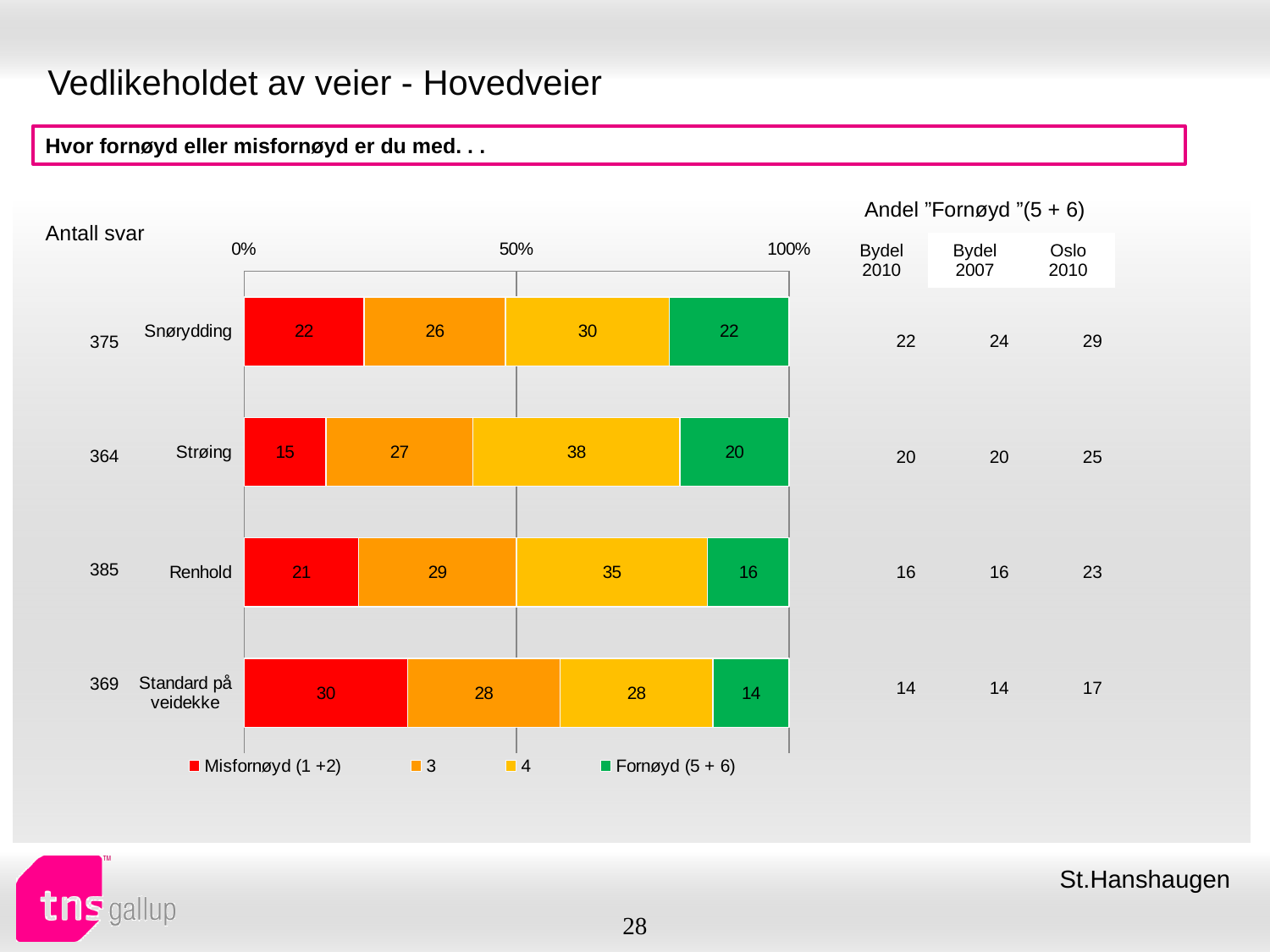
What is the total of the stacked bar for Renhold? 101 How many series does the legend list? 4 Which is larger: the 'Fornøyd (5 + 6)' value for Strøing or for Renhold? Strøing What is the value of the '4' segment for Strøing? 38 What is the value of the 'Misfornøyd (1 +2)' segment for Standard på veidekke? 30 Which category has the highest 'Misfornøyd (1 +2)' value? Standard på veidekke What is the difference between the '3' segment for Renhold and the '3' segment for Snørydding? 3 What colour represents the 'Fornøyd (5 + 6)' series in the legend? Green What kind of chart is shown on the slide? Stacked bar chart Which category has the lowest 'Fornøyd (5 + 6)' value? Standard på veidekke What is the value of the 'Fornøyd (5 + 6)' segment for Snørydding? 22 How many categories are plotted in the chart? 4